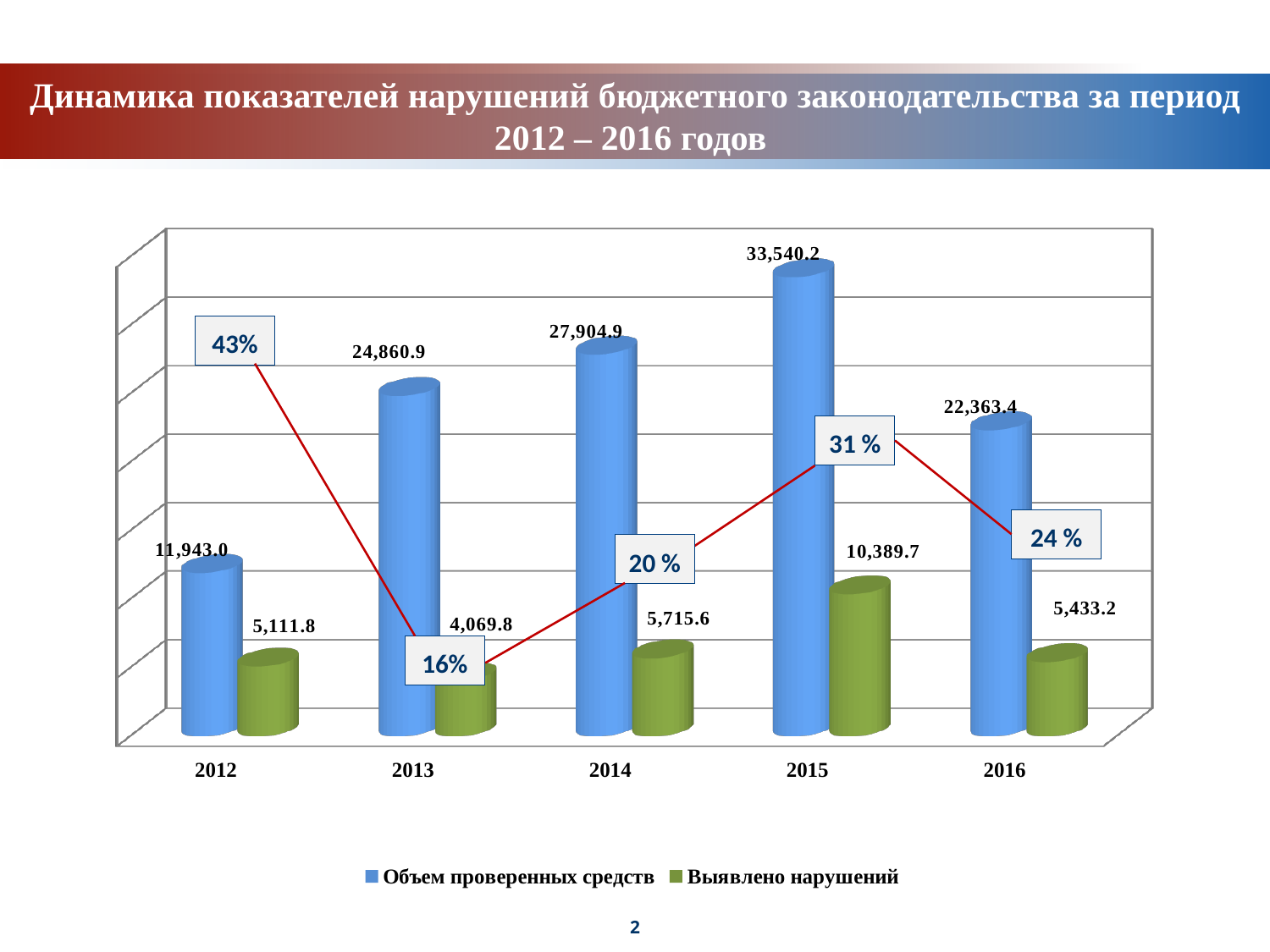
Which series is shown in green? Выявлено нарушений How many years are shown on the x axis? 5 What percentage label is shown for 2012? 43% What is the value of Выявлено нарушений for 2013? 4,069.8 What is the difference between Объем проверенных средств in 2014 and in 2013? 3,044.0 In which year is Выявлено нарушений the lowest? 2013 In which year is Объем проверенных средств the highest? 2015 How many series does the legend list? 2 Which is larger: Выявлено нарушений in 2016 or in 2012? 2016 What is the value of Объем проверенных средств for 2012? 11,943.0 What kind of chart is shown on the slide? bar chart What is the value of Объем проверенных средств for 2015? 33,540.2